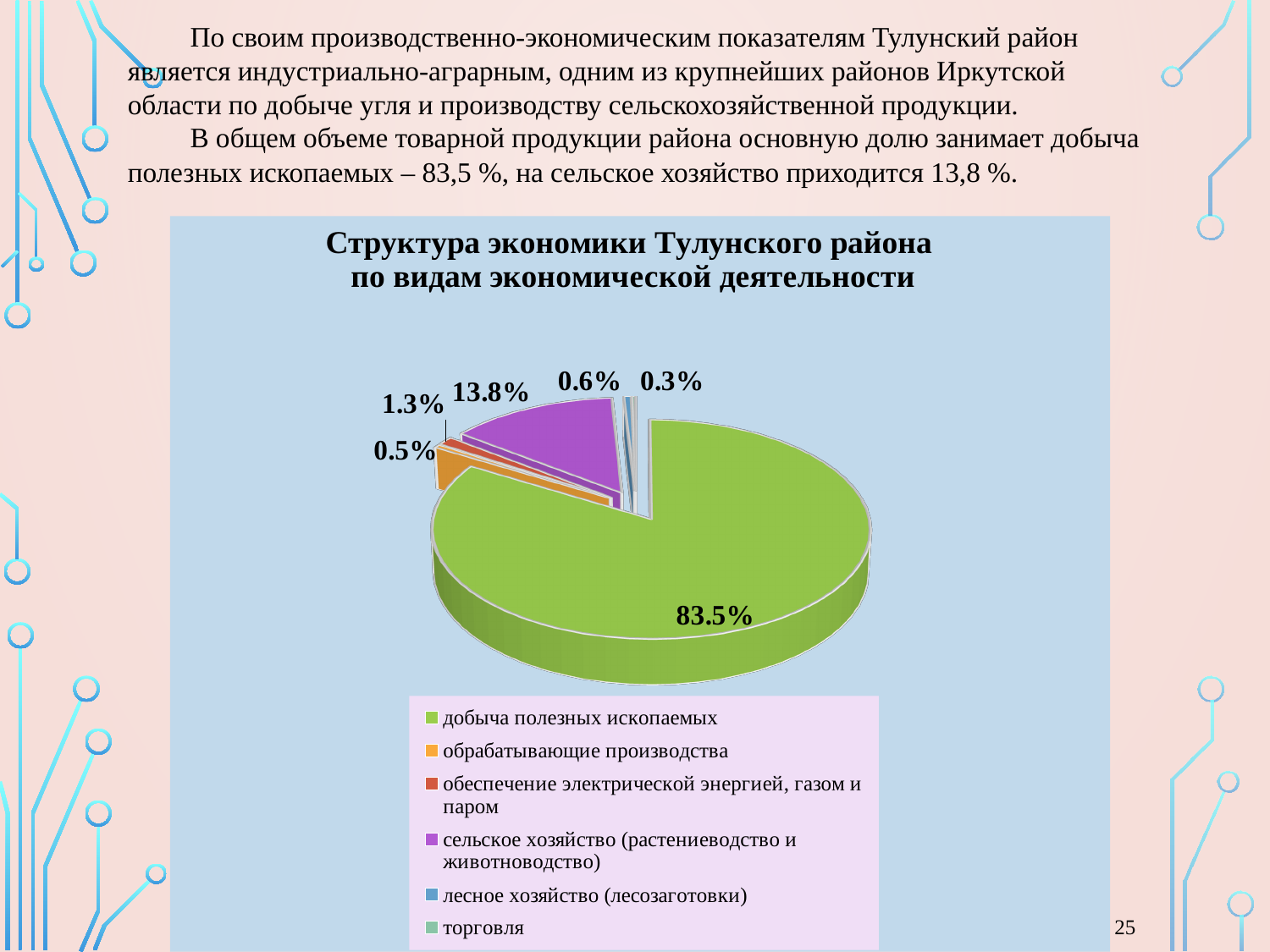
Which category has the largest slice of the pie? добыча полезных ископаемых How many categories does the legend list? 6 What colour is the largest slice of the pie? Green What is the title of the chart? Структура экономики Тулунского района по видам экономической деятельности What is the smallest percentage labelled on the pie? 0.3% Which is larger: the share of "добыча полезных ископаемых" or the share of "сельское хозяйство"? добыча полезных ископаемых What share of the pie does "добыча полезных ископаемых" have? 83.5% What share of the pie does "сельское хозяйство (растениеводство и животноводство)" have? 13.8% Is the share of "добыча полезных ископаемых" greater or less than 80%? greater What is the combined share of "добыча полезных ископаемых" and "сельское хозяйство"? 97.3% By how many percentage points does the share of "добыча полезных ископаемых" exceed the share of "сельское хозяйство"? 69.7 percentage points What type of chart is shown on the slide? Pie chart